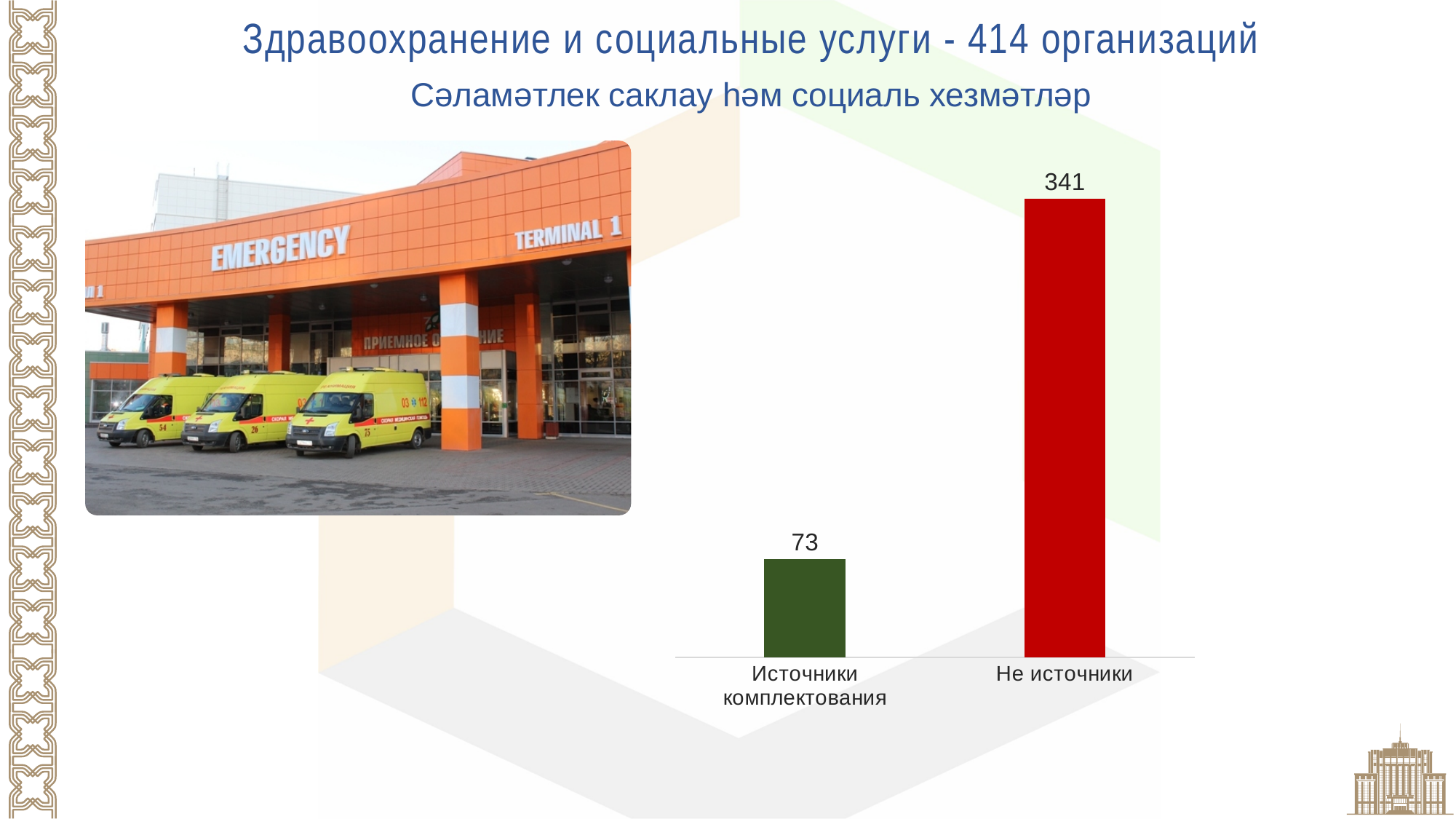
Which is larger: the value for "Источники комплектования" or the value for "Не источники"? Не источники What colour is the bar for "Не источники"? red What is the total of the two bars in the chart? 414 How many categories are shown in the chart? 2 Which category has the highest value? Не источники What is the value for "Источники комплектования"? 73 Which category has the lowest value? Источники комплектования What colour is the bar for "Источники комплектования"? dark green What is the difference between the values for "Не источники" and "Источники комплектования"? 268 What kind of chart is shown on the slide? bar chart What is the value for "Не источники"? 341